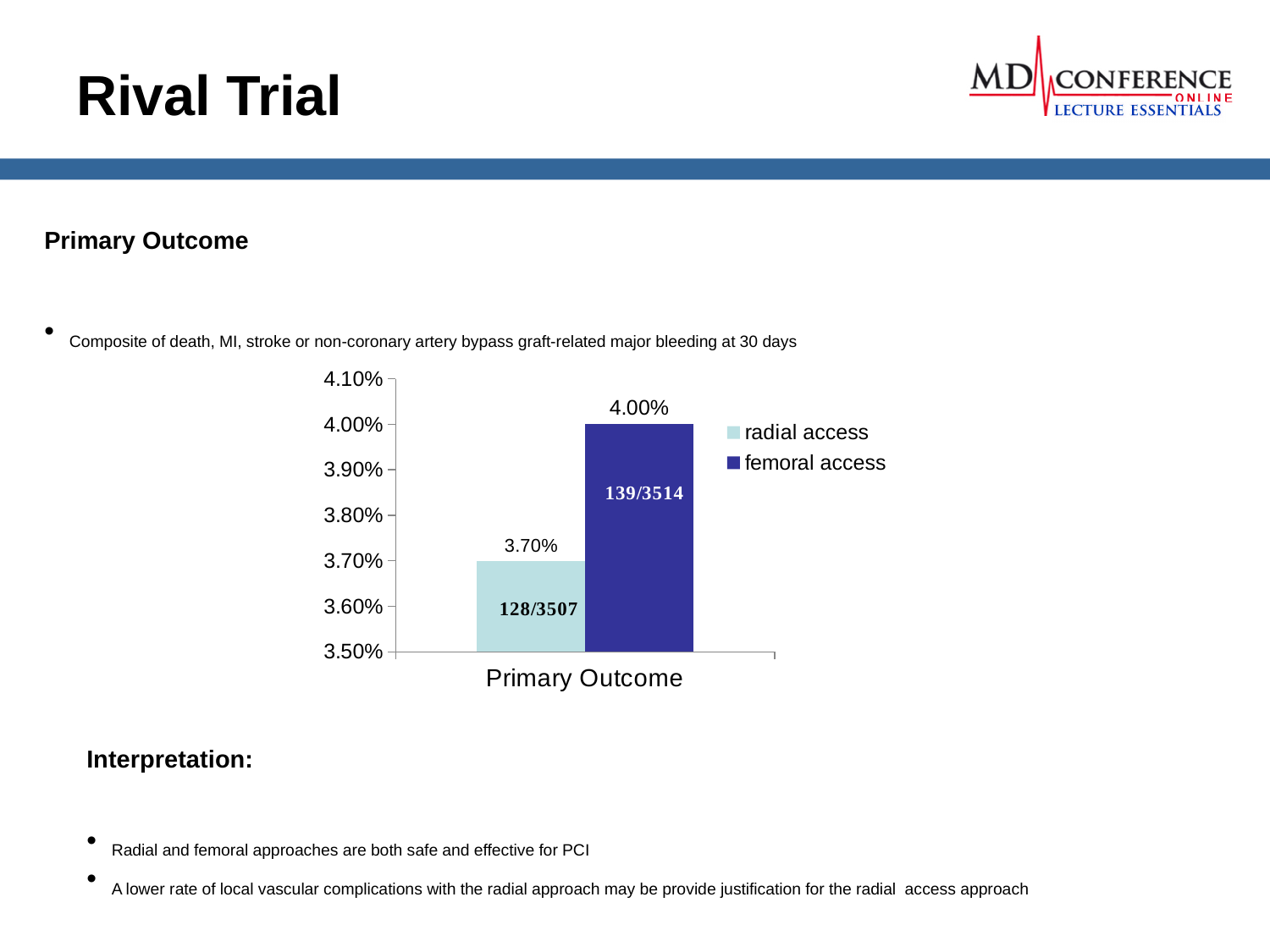
What is the value for femoral access in the Primary Outcome chart? 4.00% What is the category label on the x axis of the chart? Primary Outcome What fraction is printed on the radial access bar? 128/3507 Which series has the higher value in the Primary Outcome chart? femoral access What is the value for radial access in the Primary Outcome chart? 3.70% What is the difference between the femoral access and radial access values? 0.30% Which series has the lower value in the Primary Outcome chart? radial access What fraction is printed on the femoral access bar? 139/3514 Is the value for radial access greater or less than the value for femoral access? less How many series does the legend list? 2 Is the value for femoral access greater or less than 3.90%? greater What kind of chart is shown on the slide? bar chart